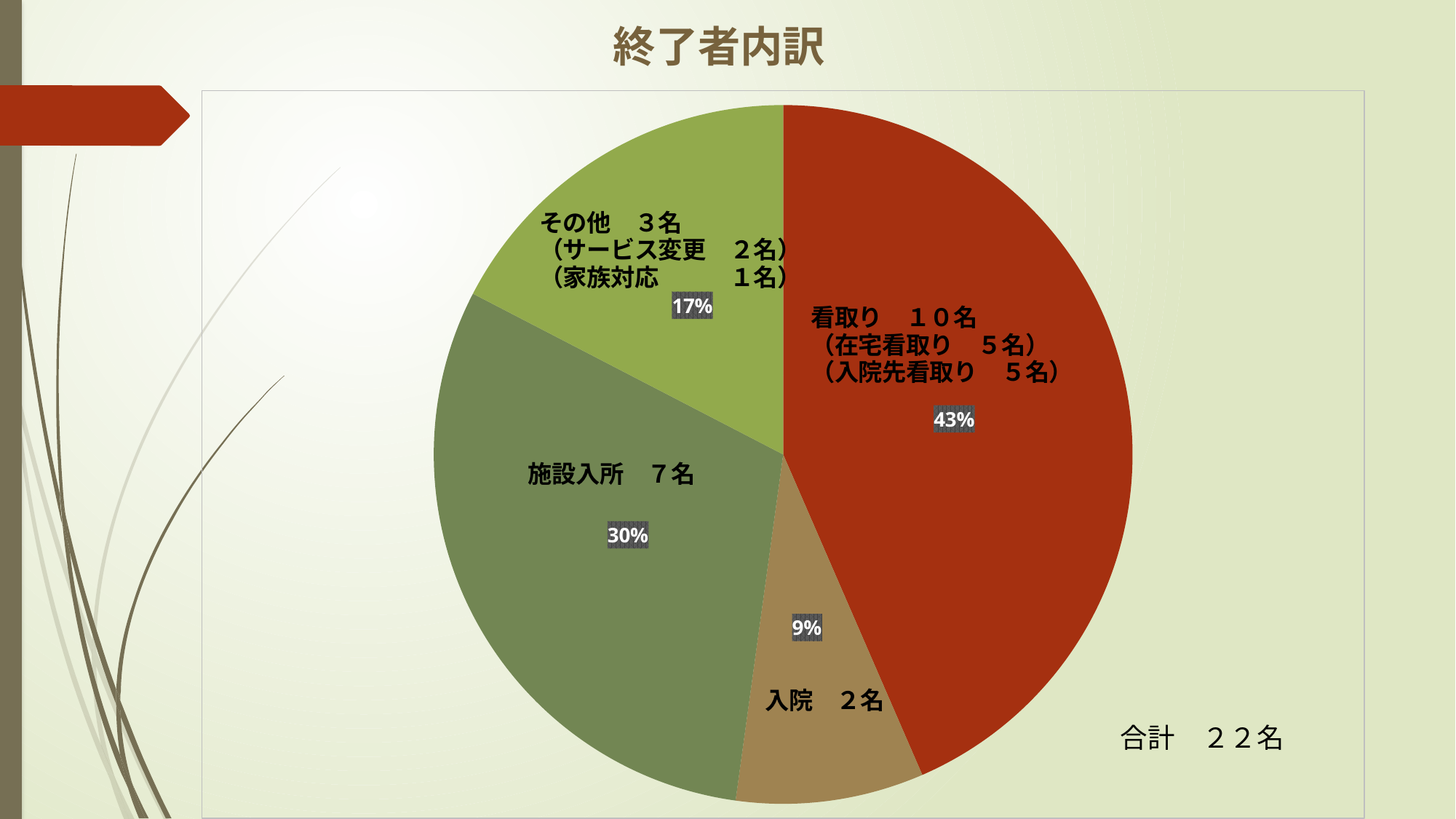
What is the total number of people shown on the slide (合計)? ２２名 How many slices does the pie chart have? 4 What percentage share does the 施設入所 slice have? 30% How many people are in the 施設入所 category? ７名 What percentage share does the その他 slice have? 17% Which category has the largest slice? 看取り How many people are in the 看取り category? １０名 What is the title of the chart? 終了者内訳 What percentage share does the 入院 slice have? 9% Which category has the smallest slice? 入院 What kind of chart is shown on the slide? pie chart